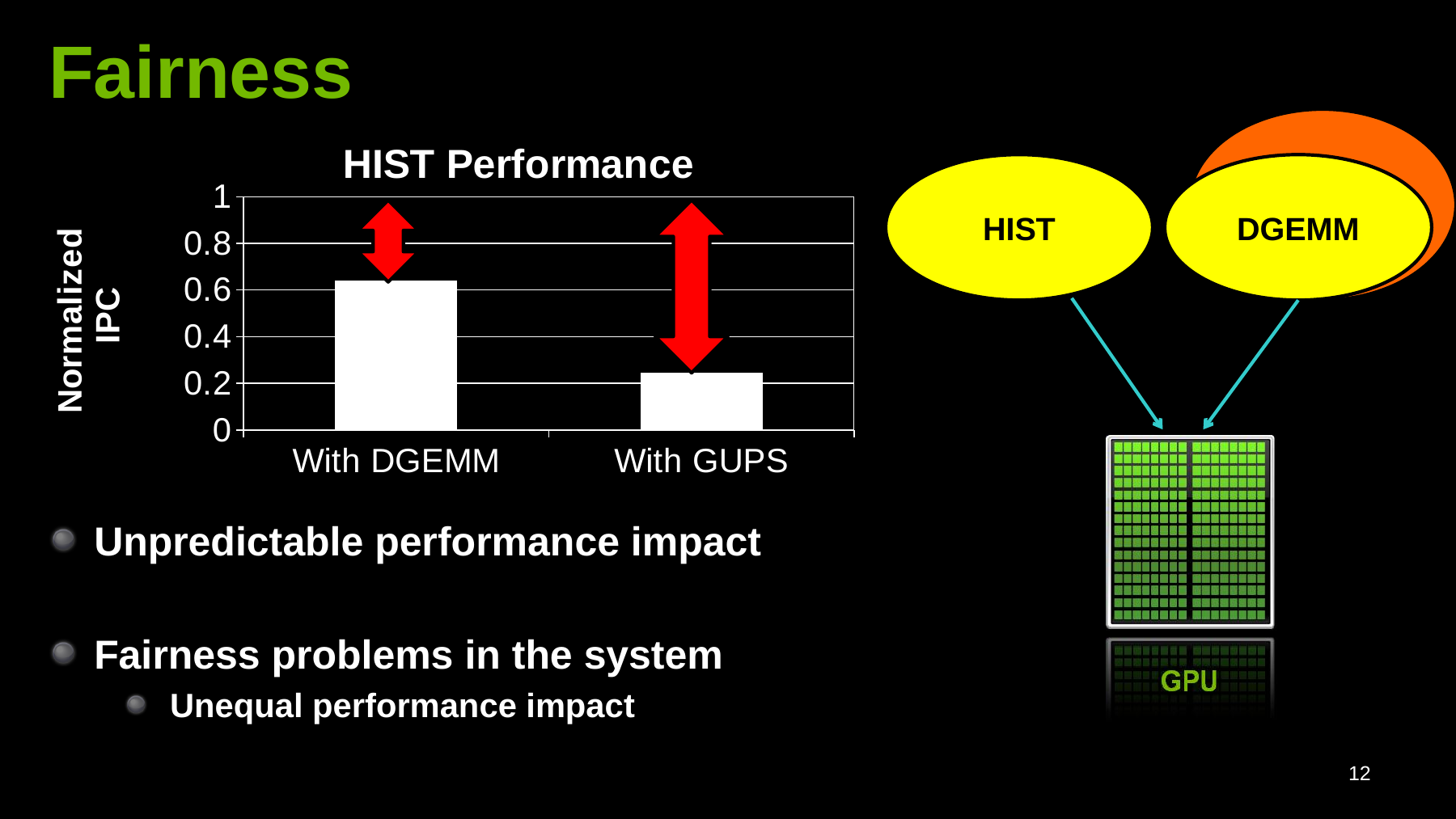
How many categories are shown on the x axis of the chart? 2 What kind of chart is shown on the slide? bar chart Which is larger, the normalized IPC With DGEMM or With GUPS? With DGEMM Do the values rise or fall from With DGEMM to With GUPS? fall What is the label of the vertical axis of the chart? Normalized IPC Is the value for With GUPS greater or less than 0.4? less Is the value for With DGEMM greater or less than 0.8? less Which category has the highest normalized IPC? With DGEMM Is the value for With DGEMM greater or less than 0.4? greater Which category has the lowest normalized IPC? With GUPS What is the title of the chart? HIST Performance